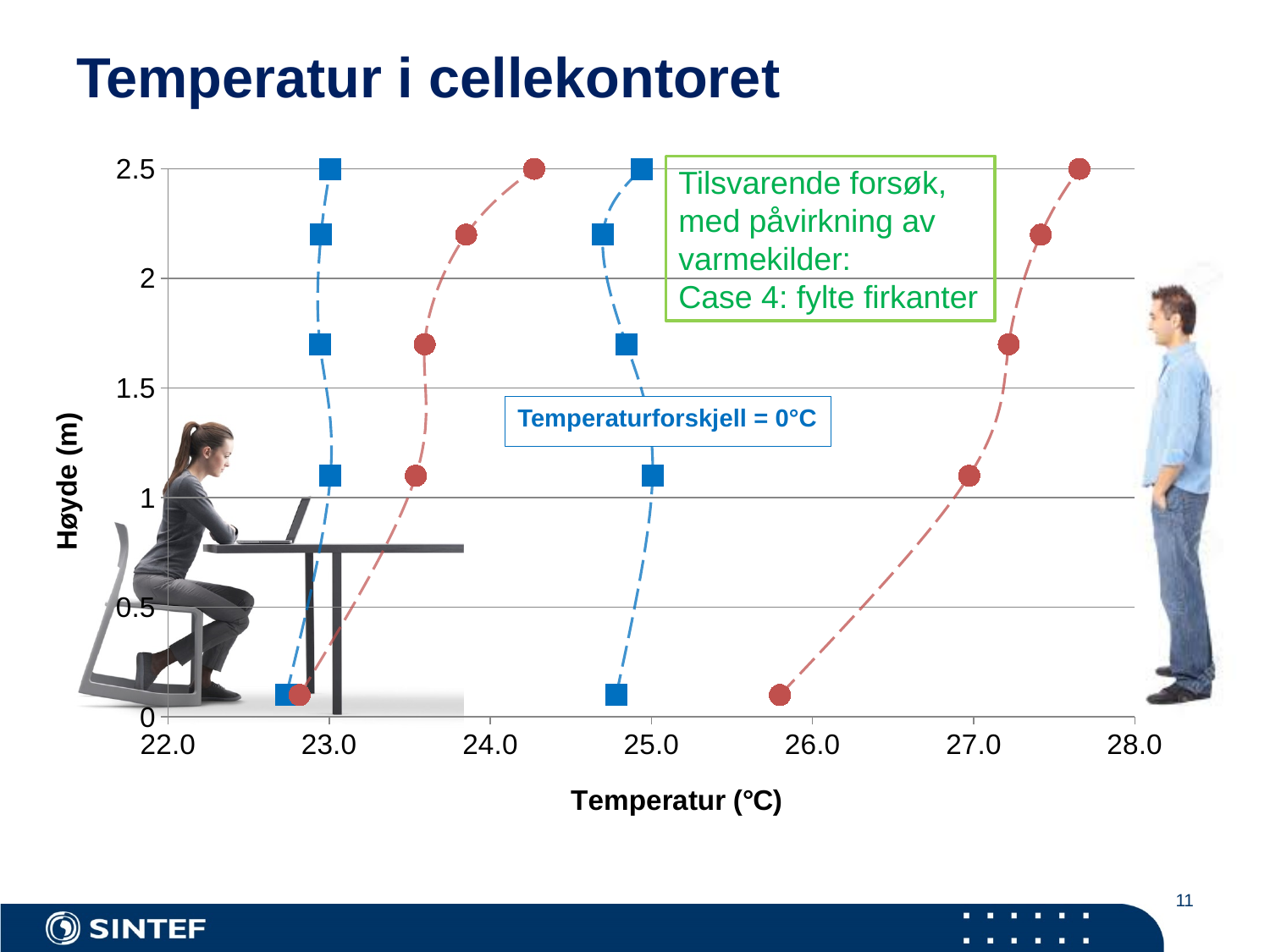
Is the temperature of the left red circle series at a height of 1.1 m greater or less than 23.0? greater How many series are plotted on the chart? 4 For the rightmost red circle series, does the temperature rise or fall as height increases? Rises What is the title of the x axis? Temperatur (°C) How many data points does the rightmost red circle series have? 5 Is the temperature of the right blue square series at a height of 0.1 m greater or less than 25.0? less At a height of 2.5 m, which is larger: the temperature of the leftmost blue square series or the rightmost red circle series? The rightmost red circle series What is the title of the y axis? Høyde (m) Is the temperature of the rightmost red circle series at a height of 2.5 m greater or less than 27.0? greater What kind of chart is shown on the slide? Line chart with markers (scatter) Which series has the highest temperature at a height of 2.5 m? The rightmost red circle series